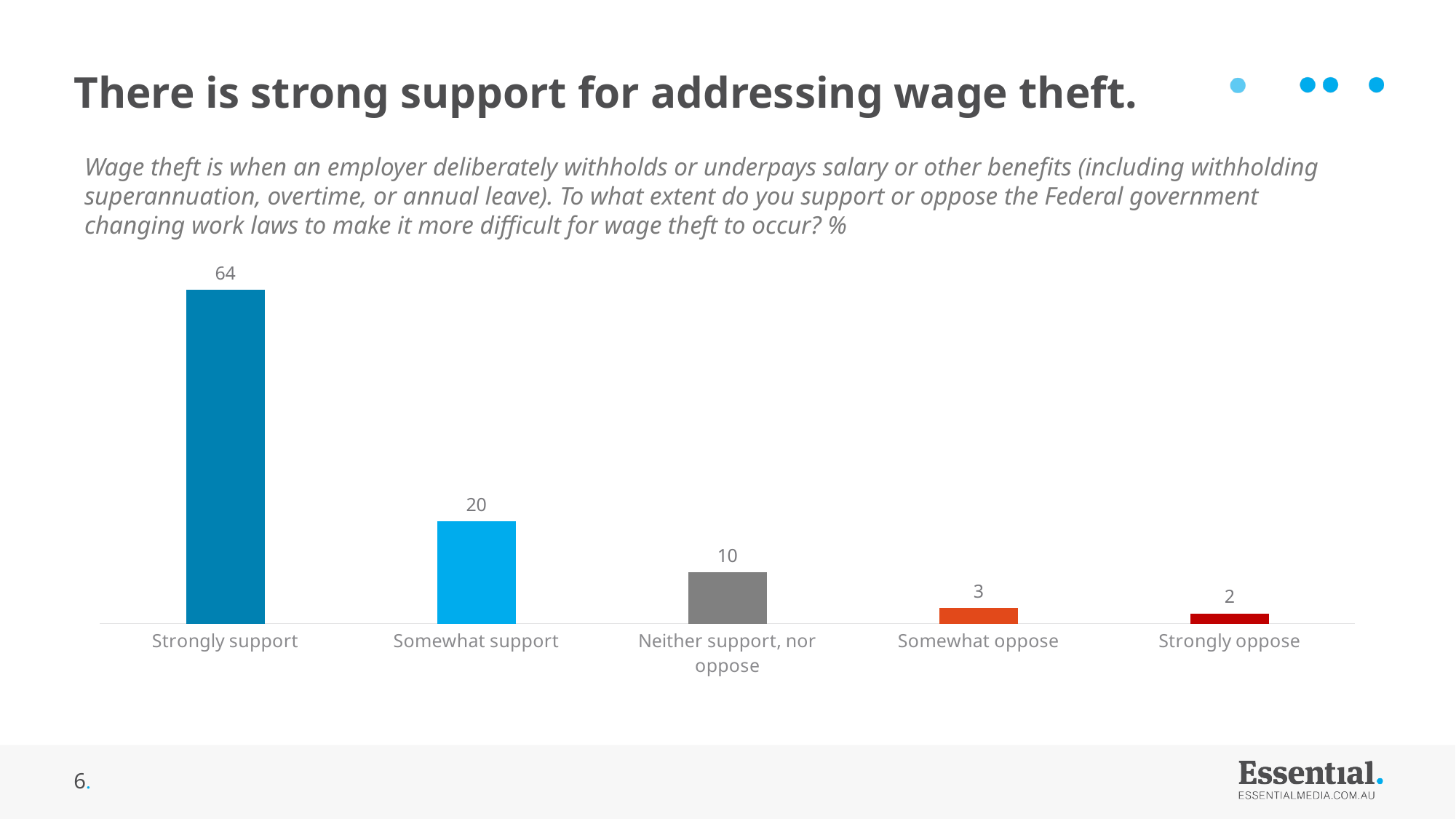
How many categories are shown on the chart? 5 What is the difference between the values for Strongly support and Somewhat support? 44 Which category has the highest value? Strongly support Which is larger, the value for Somewhat support or the value for Neither support, nor oppose? Somewhat support Which category has the lowest value? Strongly oppose What kind of chart is shown on the slide? Bar chart What is the value for Neither support, nor oppose? 10 What is the value for Somewhat support? 20 What is the value for Strongly oppose? 2 Do the values rise or fall moving from left to right along the x axis? Fall What is the value for Somewhat oppose? 3 What is the value for Strongly support? 64